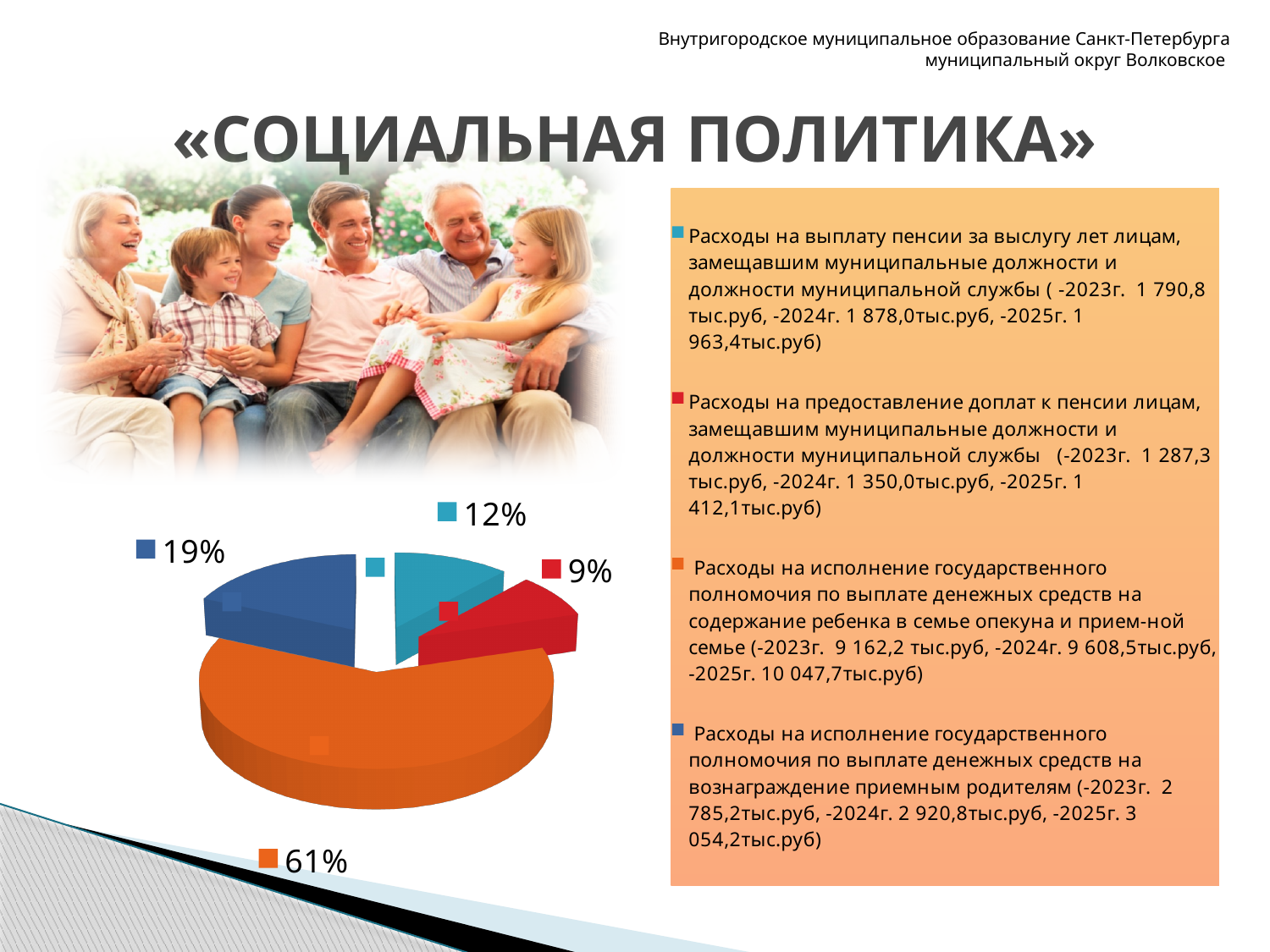
What is the title shown above the chart on the slide? «СОЦИАЛЬНАЯ ПОЛИТИКА» What percentage is labelled on the red slice of the pie chart? 9% What is the largest percentage shown on the pie chart? 61% What percentage is labelled on the light blue slice of the pie chart? 12% What kind of chart is shown on the slide? Pie chart What is the smallest percentage shown on the pie chart? 9% What percentage is labelled on the dark blue slice of the pie chart? 19% What is the difference in percentage points between the light blue slice (12%) and the red slice (9%)? 3 percentage points Which is larger on the pie chart: the dark blue slice or the light blue slice? The dark blue slice (19%) How many slices does the pie chart have? 4 What percentage is labelled on the orange slice of the pie chart? 61% What is the difference in percentage points between the largest slice (61%) and the dark blue slice (19%)? 42 percentage points